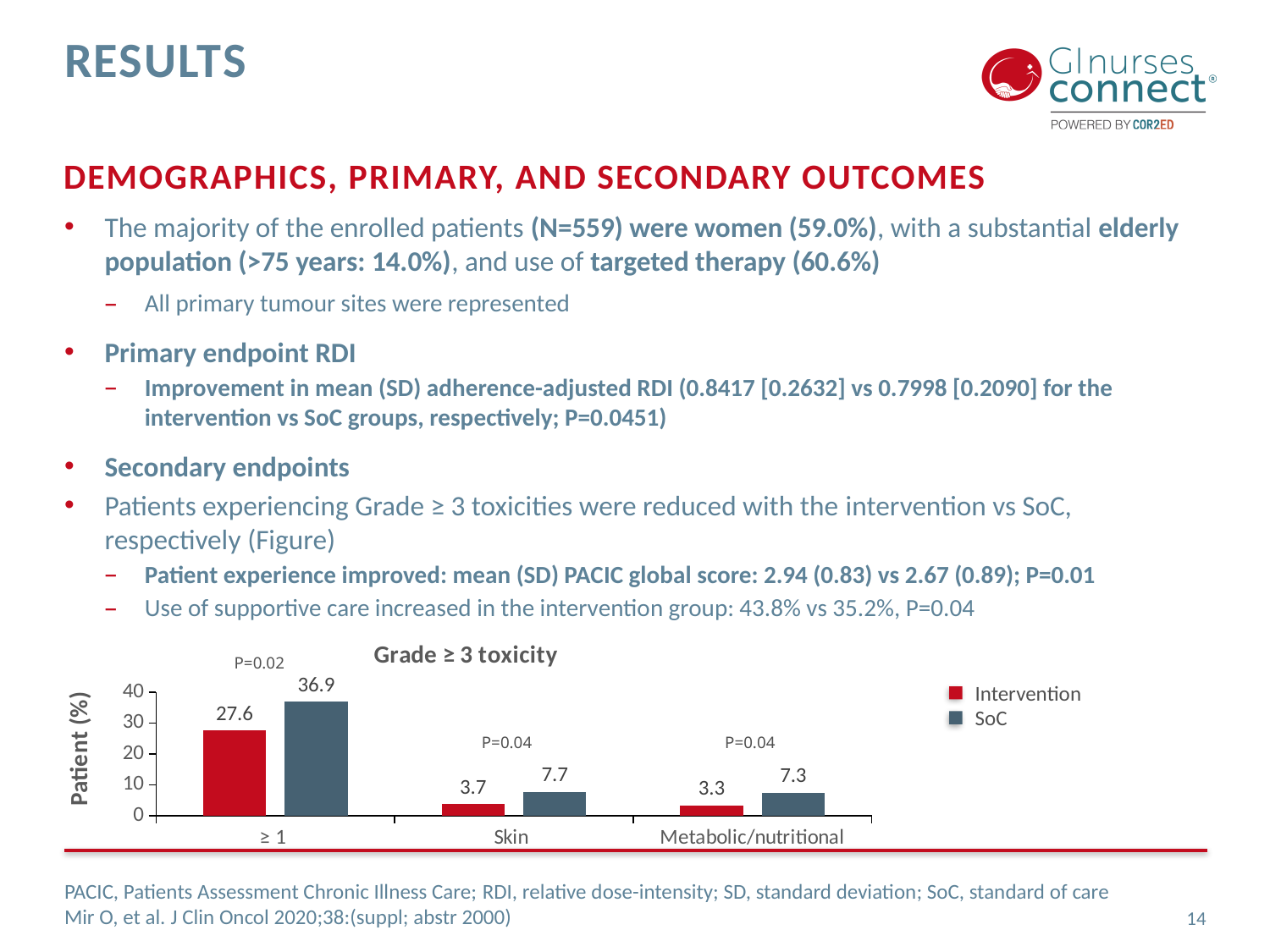
How many series does the legend list? 2 Which category has the lowest Intervention value? Metabolic/nutritional How many categories are shown on the x axis of the chart? 3 Which category has the highest SoC value? ≥ 1 What is the SoC value for the Skin category? 7.7 What is the Intervention value for Metabolic/nutritional? 3.3 What kind of chart is shown on the slide? Bar chart What is the difference between the SoC and Intervention values for Skin? 4.0 Which is larger for Metabolic/nutritional, the Intervention value or the SoC value? SoC What is the Intervention value for the ≥ 1 category in the Grade ≥ 3 toxicity chart? 27.6 What is the difference between the SoC and Intervention values for the ≥ 1 category? 9.3 What is the title of the chart? Grade ≥ 3 toxicity